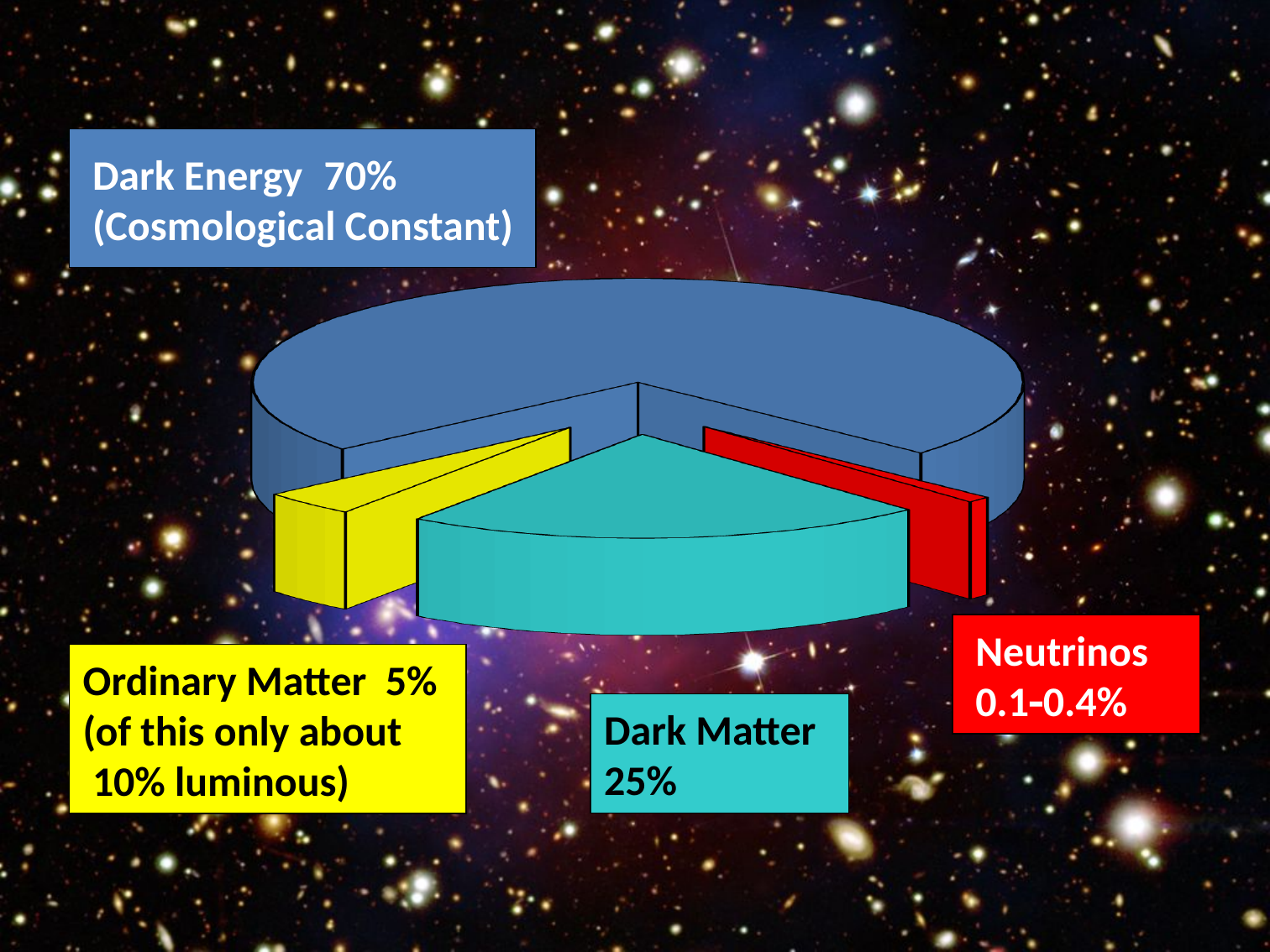
What kind of chart is shown on the slide? pie chart How many slices does the pie chart have? 4 What colour is the Dark Matter slice? cyan What share of the pie does Ordinary Matter account for? 5% What share of the pie does Dark Matter account for? 25% What share of the pie does Dark Energy account for? 70% What is the difference between the Dark Energy share and the Dark Matter share? 45% What colour is the Neutrinos slice? red Which slice of the pie is the smallest? Neutrinos Which is larger, the Dark Matter share or the Ordinary Matter share? Dark Matter What value is given for Neutrinos? 0.1-0.4% Which slice of the pie is the largest? Dark Energy